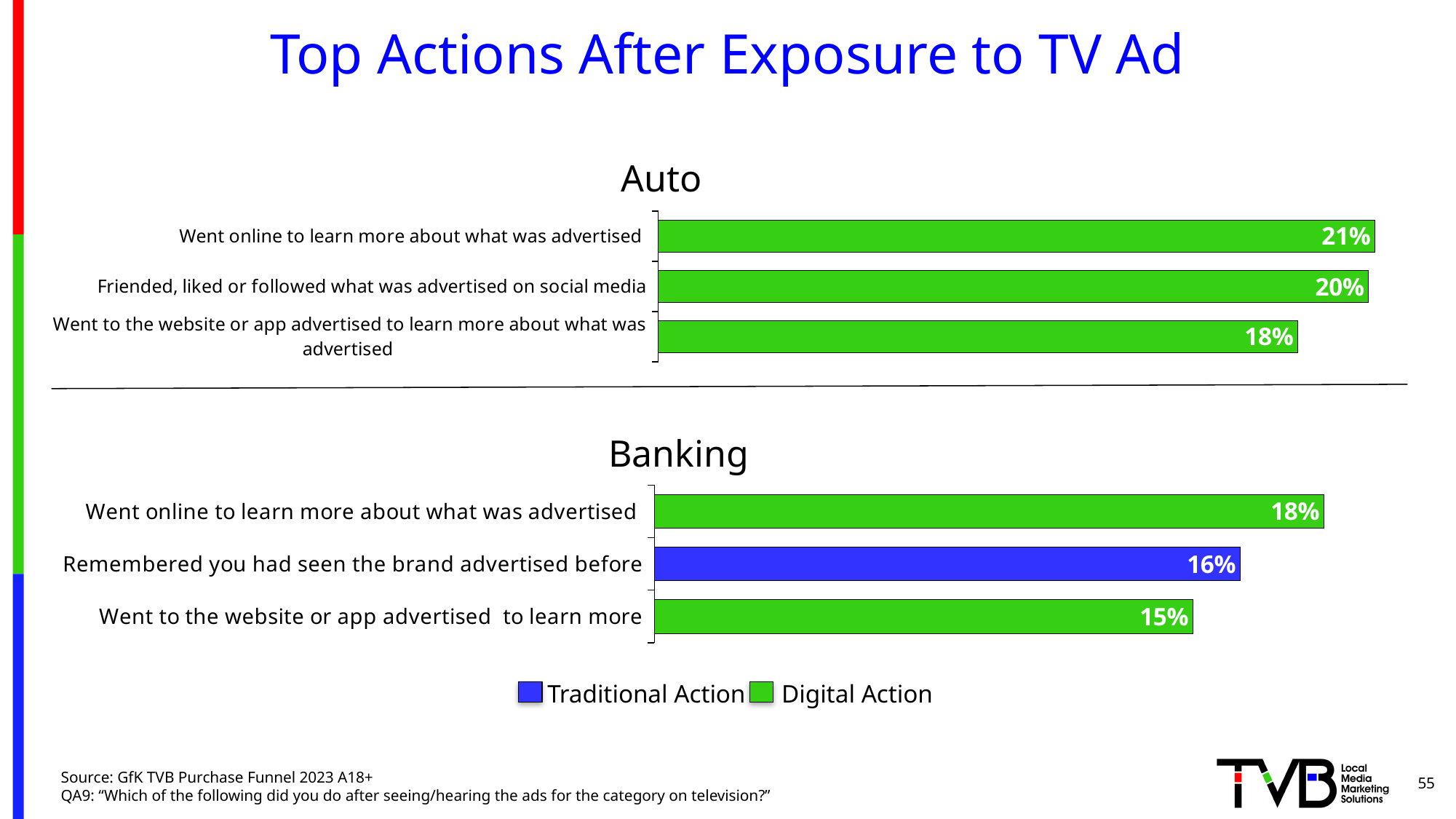
In the Banking chart, what is the value for "Went to the website or app advertised to learn more"? 15% How many series does the legend list? 2 Which is larger: "Went online to learn more about what was advertised" in the Auto chart or in the Banking chart? Auto In the Auto chart, which action has the lowest value? Went to the website or app advertised to learn more about what was advertised In the Auto chart, what is the value for "Went online to learn more about what was advertised"? 21% What type of chart is the Auto chart? Bar chart In the Banking chart, which action has the highest value? Went online to learn more about what was advertised In the Banking chart, what is the difference between "Went online to learn more about what was advertised" and "Remembered you had seen the brand advertised before"? 2% In the Banking chart, what is the value for "Remembered you had seen the brand advertised before"? 16% In the Auto chart, what is the difference between "Went online to learn more about what was advertised" and "Went to the website or app advertised to learn more about what was advertised"? 3% In the Auto chart, what is the value for "Friended, liked or followed what was advertised on social media"? 20% How many actions are shown in the Banking chart? 3